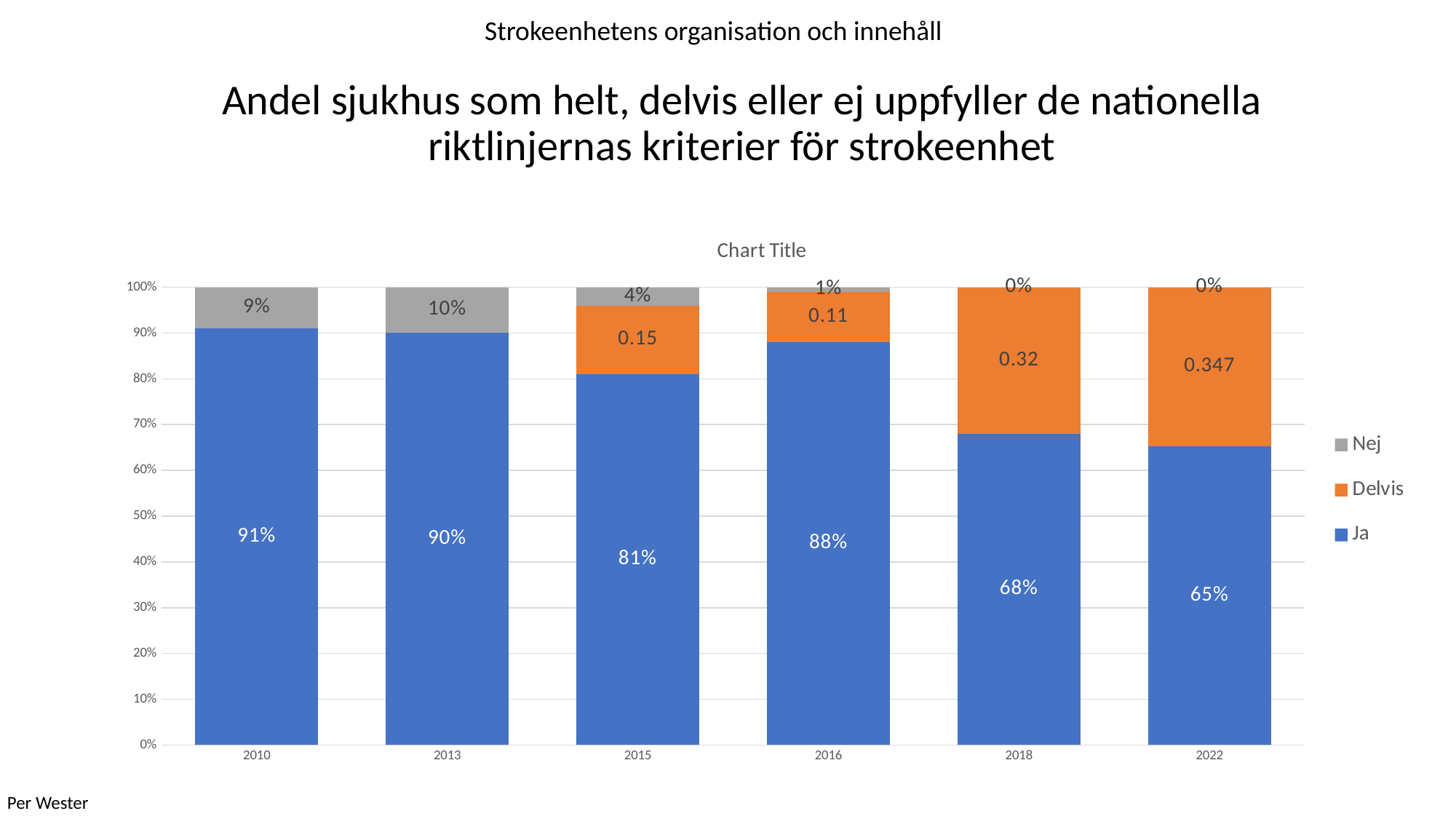
How many series does the legend list? 3 What type of chart is shown on the slide? stacked bar chart How many years are shown on the x axis? 6 What is the value for Ja in 2022? 65% Which year has the highest value for Ja? 2010 What is the value for Nej in 2013? 10% What is the difference between the Ja value in 2010 and the Ja value in 2022? 26% What is the value for Delvis in 2018? 0.32 What is the value for Ja in 2010? 91% Which year has the lowest value for Ja? 2022 What is the value for Delvis in 2022? 0.347 Which is larger, the Ja value in 2016 or the Ja value in 2018? 2016